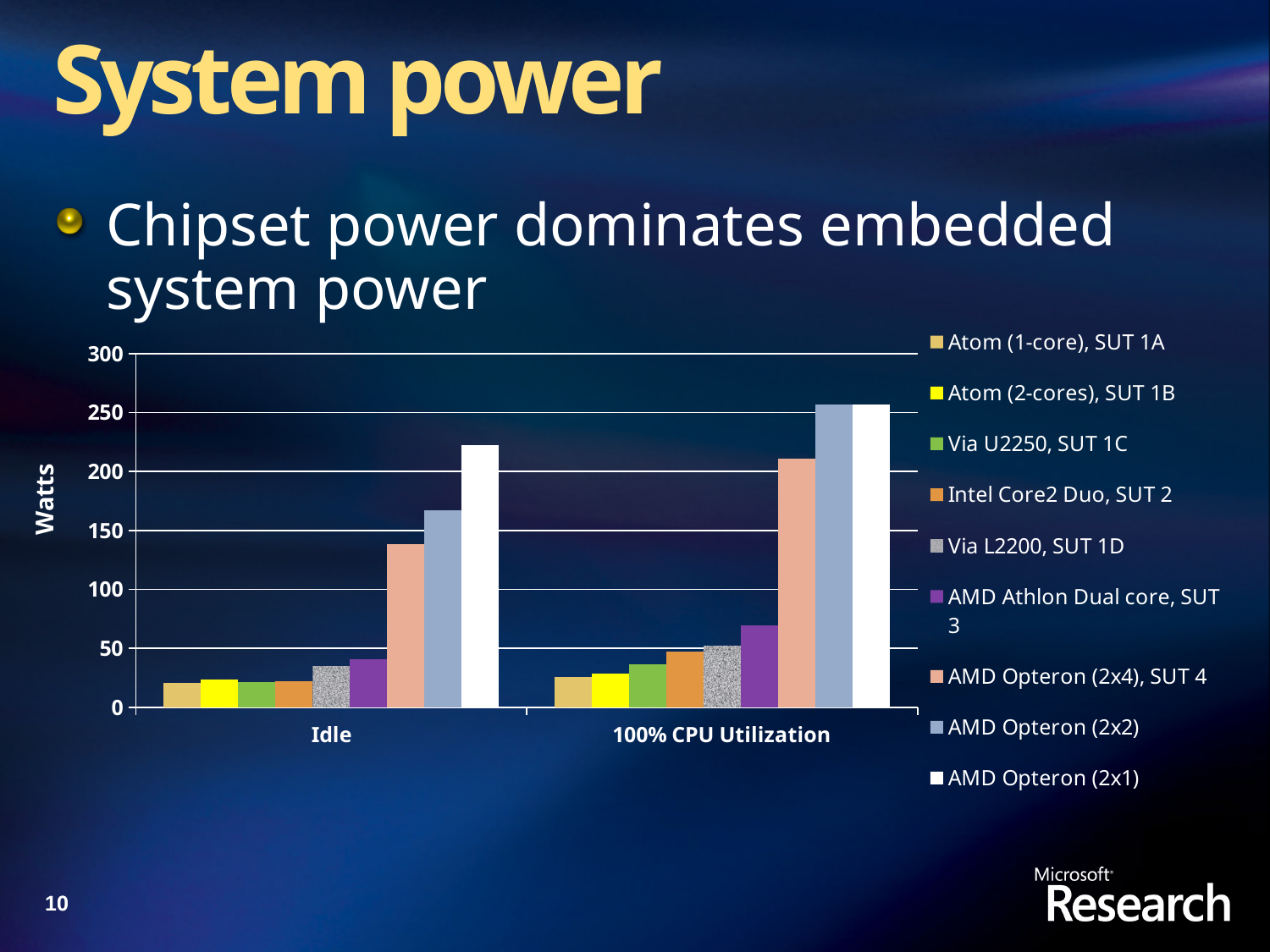
Is the Idle value for AMD Opteron (2x4), SUT 4 greater or less than 150? less How many categories are shown on the x axis of the chart? 2 For AMD Opteron (2x4), SUT 4, which category has the larger value: Idle or 100% CPU Utilization? 100% CPU Utilization Is the 100% CPU Utilization value for AMD Athlon Dual core, SUT 3 greater or less than 50? greater Do the values for AMD Opteron (2x2) rise or fall from Idle to 100% CPU Utilization? rise Is the 100% CPU Utilization value for AMD Opteron (2x2) greater or less than 250? greater How many series does the chart's legend list? 9 What kind of chart is shown on the slide? bar chart What is the label of the y axis of the chart? Watts Which series has the lowest value in the 100% CPU Utilization category? Atom (1-core), SUT 1A Which series has the highest value in the Idle category? AMD Opteron (2x1)